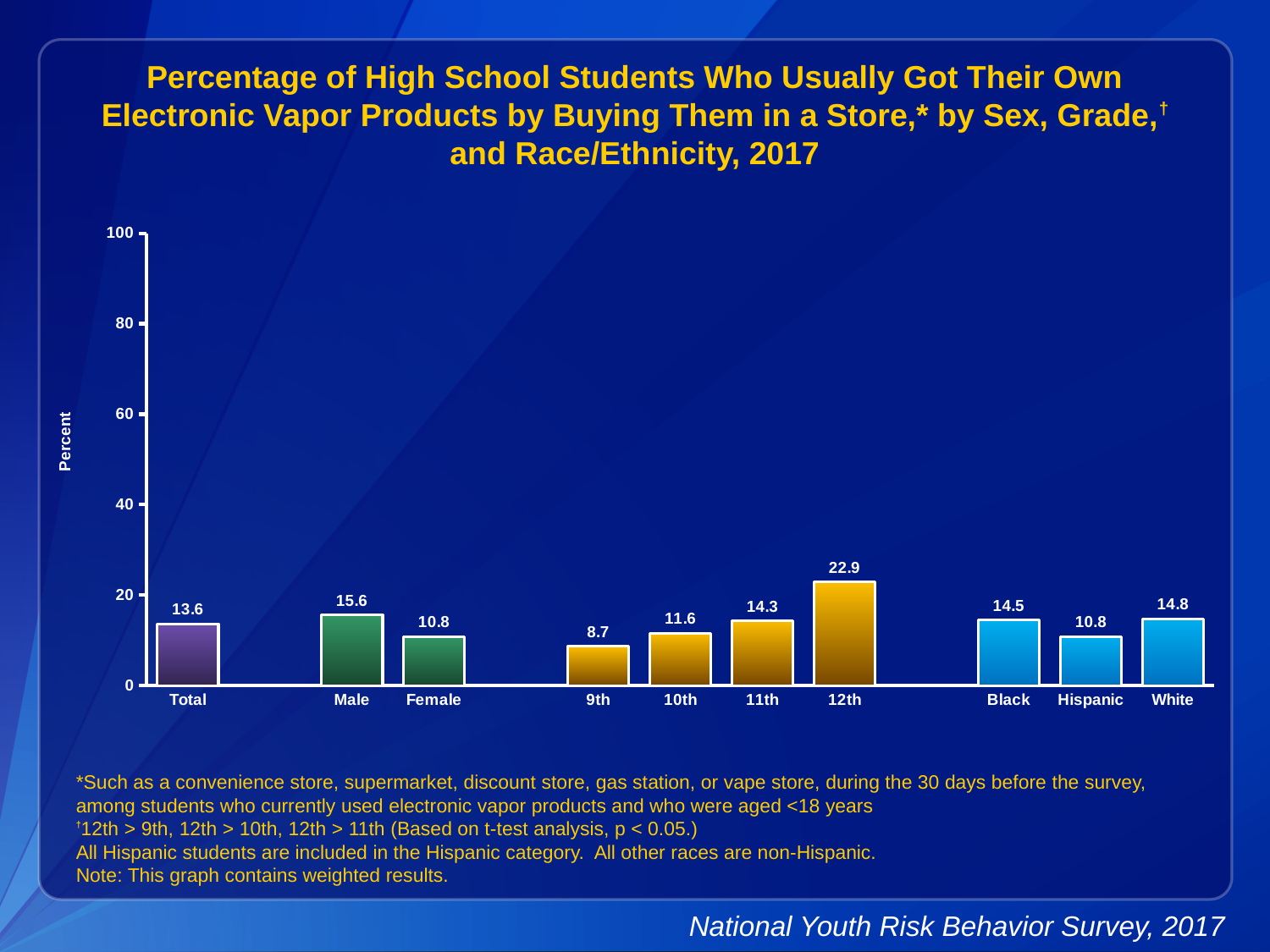
What is the value for Total? 13.6 How many categories are shown on the x axis? 10 Is the value for 12th grade greater or less than 20? greater What kind of chart is this? bar chart Do the values rise or fall from 9th grade to 12th grade? rise What is the label on the y axis? Percent Which is larger, the value for Black or the value for White? White Which category has the highest value? 12th Which category has the lowest value? 9th What is the value for Hispanic students? 10.8 What is the value for 12th grade? 22.9 What is the difference between the values for Male and Female? 4.8